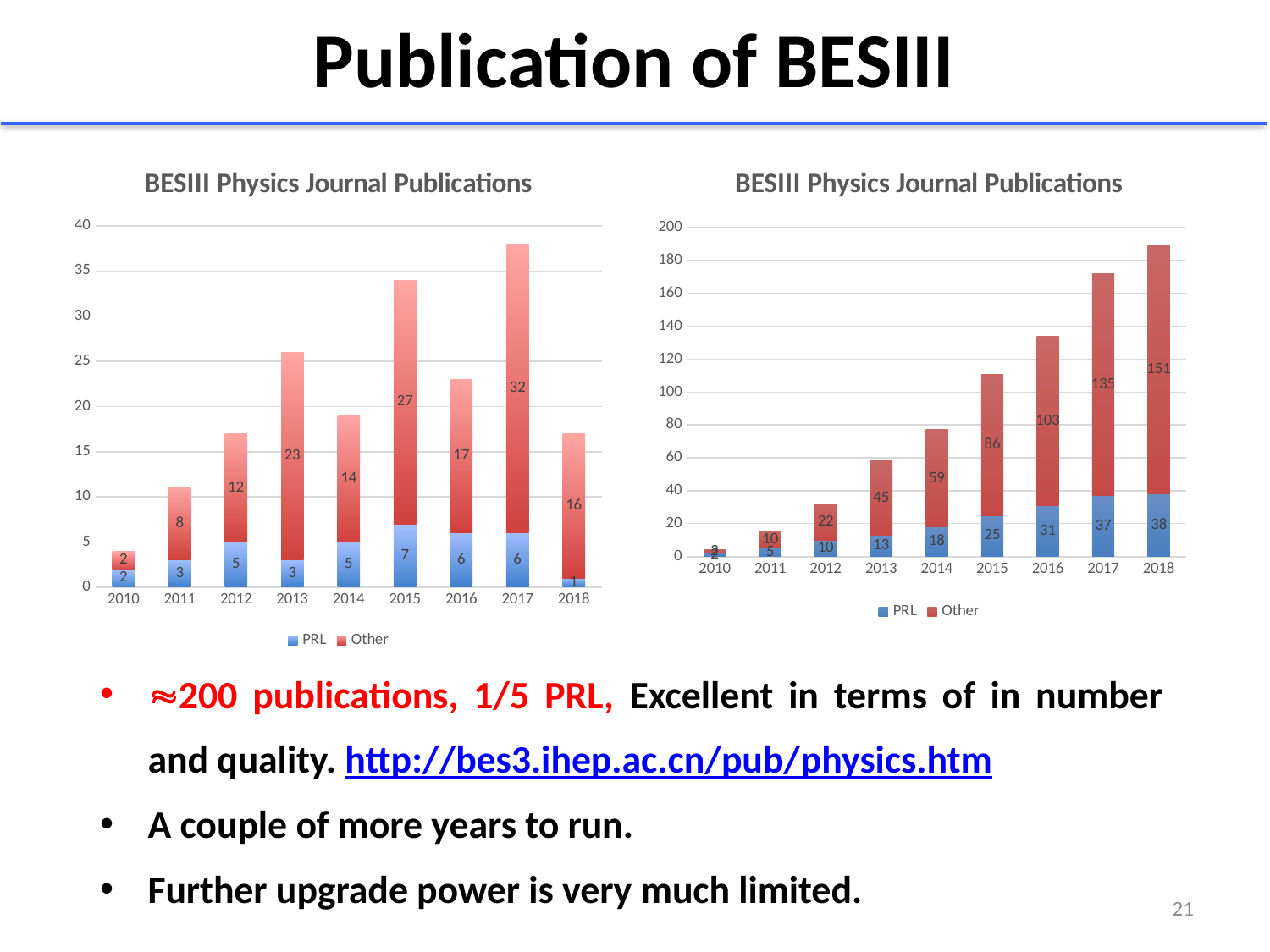
In the left chart, which year has the highest Other value? 2017 In the left chart, what is the difference between the Other values for 2013 and 2014? 9 In the right chart, what is the Other value for 2018? 151 How many series does the legend of the left chart list? 2 In the left chart, what is the total of the stacked bar for 2015? 34 In the left chart, how many PRL publications are shown for 2015? 7 In the left chart, which year has the lowest PRL value? 2018 In the left chart, how many Other publications are shown for 2017? 32 In the right chart, do the Other values rise or fall from 2010 to 2018? rise In the right chart, what is the PRL value for 2016? 31 In the right chart, what is the total of the stacked bar for 2017? 172 In the right chart, is the total for 2018 greater or less than 180? greater